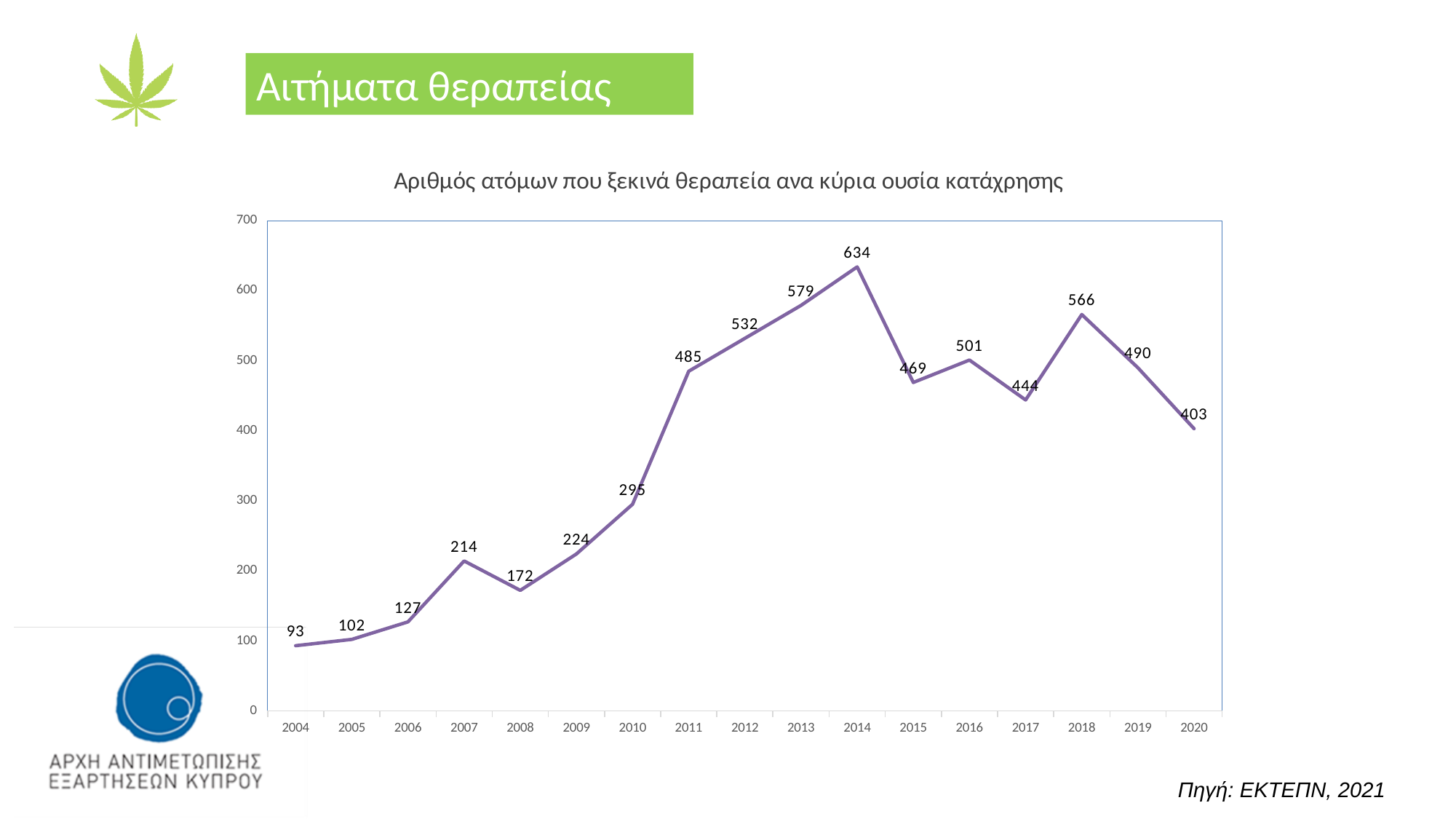
Is the value for 2011 greater or less than 400? greater Which year has the lowest value? 2004 Do the values rise or fall from 2004 to 2014? rise What is the difference between the values for 2014 and 2015? 165 Which year has the highest value? 2014 What is the value for 2004? 93 How many years are plotted on the x axis? 17 What kind of chart is shown? line chart Which is larger, the value for 2018 or the value for 2019? 2018 What is the title of the chart? Αριθμός ατόμων που ξεκινά θεραπεία ανα κύρια ουσία κατάχρησης What is the value for 2020? 403 What is the value for 2014? 634